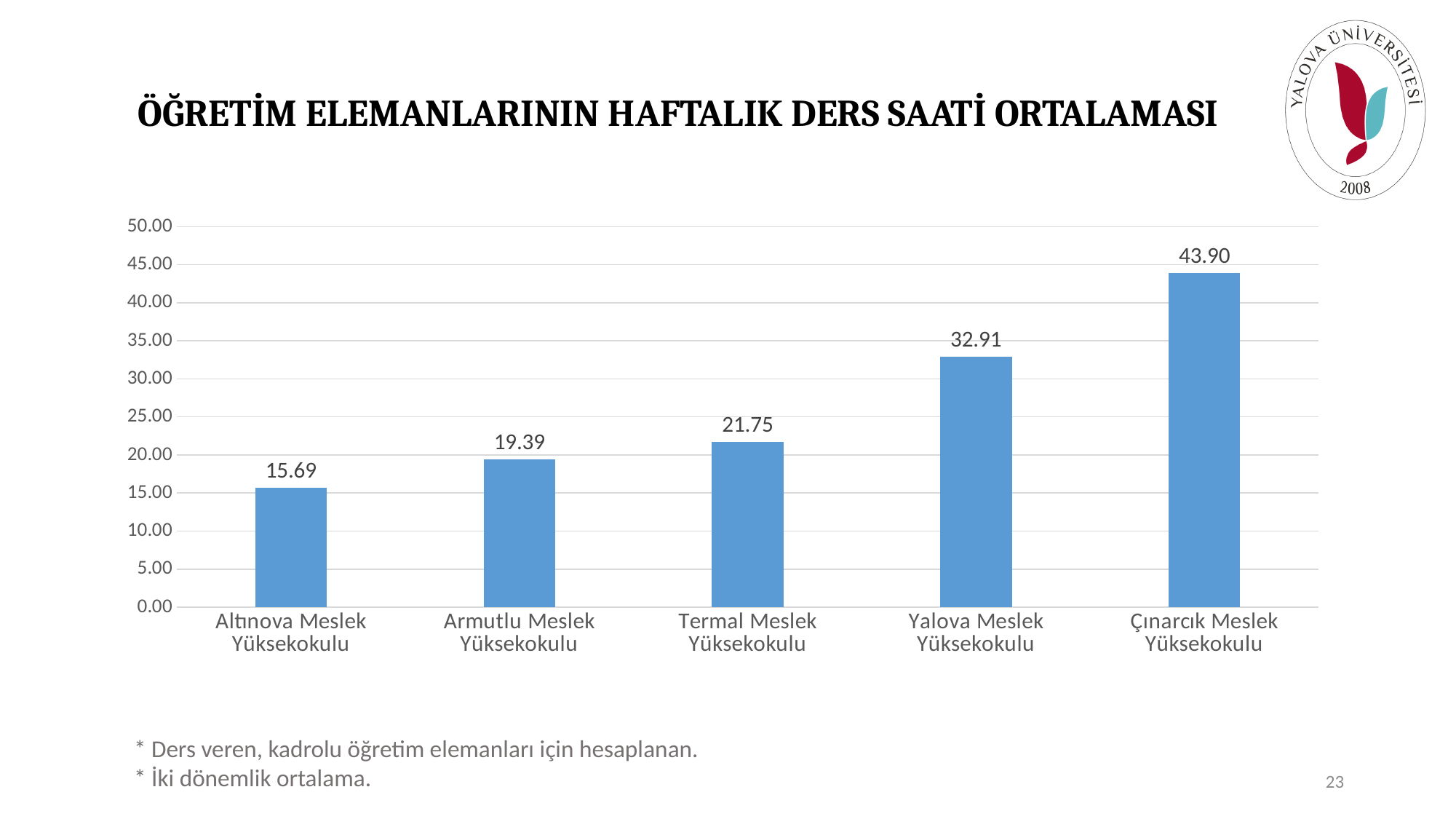
Which category has the highest value? Çınarcık Meslek Yüksekokulu What is the value for Termal Meslek Yüksekokulu? 21.75 Is the value for Yalova Meslek Yüksekokulu greater or less than 30.00? greater What kind of chart is shown on the slide? bar chart What is the difference between the values for Çınarcık Meslek Yüksekokulu and Yalova Meslek Yüksekokulu? 10.99 What is the value for Yalova Meslek Yüksekokulu? 32.91 Which category has the lowest value? Altınova Meslek Yüksekokulu What is the difference between the values for Armutlu Meslek Yüksekokulu and Altınova Meslek Yüksekokulu? 3.70 Which is larger, the value for Termal Meslek Yüksekokulu or Armutlu Meslek Yüksekokulu? Termal Meslek Yüksekokulu How many categories are shown on the x axis? 5 Do the values rise or fall from left to right along the x axis? rise What is the value for Altınova Meslek Yüksekokulu? 15.69